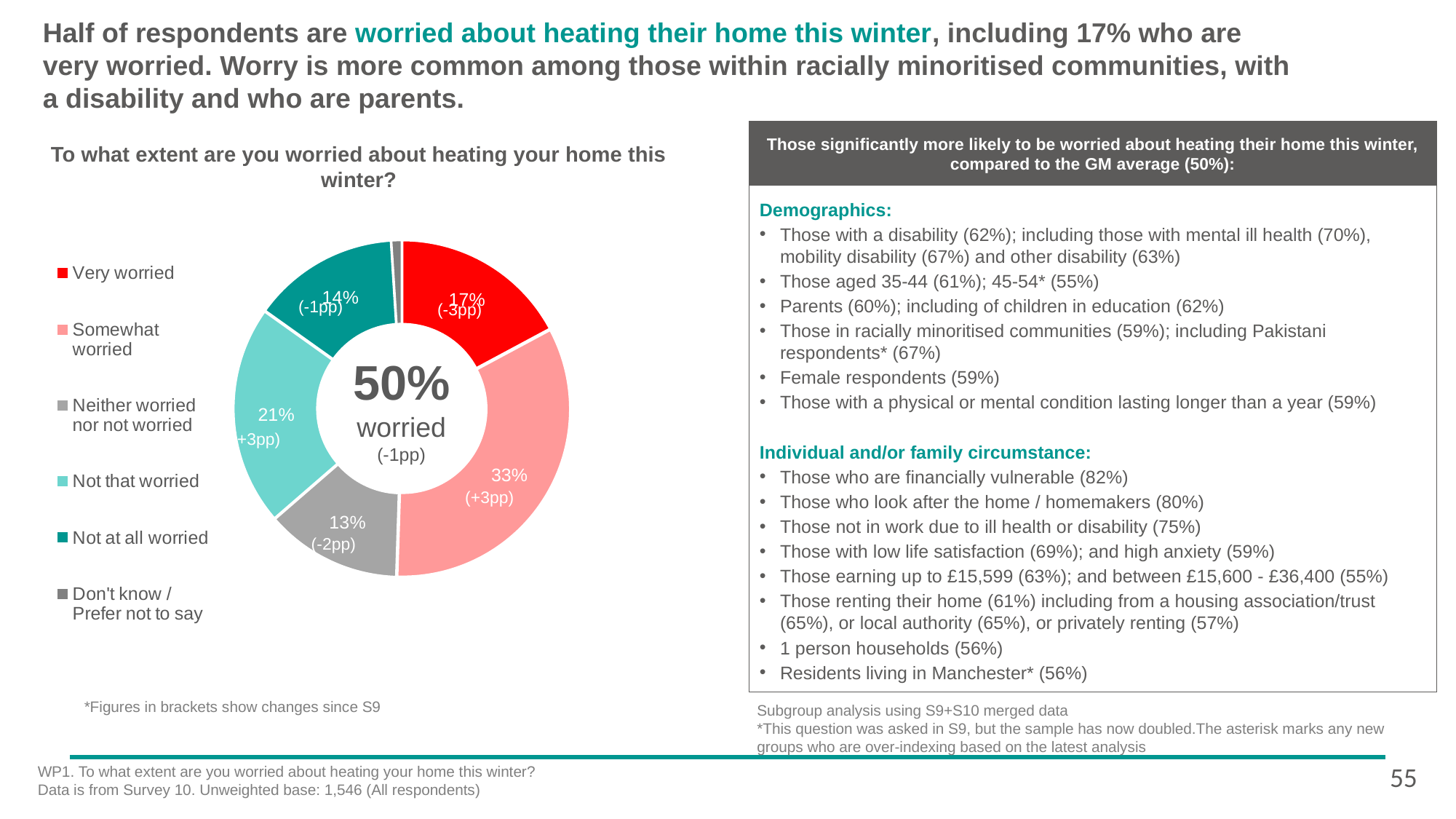
What is the change since S9 shown for the overall 'worried' figure in the centre of the chart? -1pp What percentage of respondents are very worried about heating their home this winter? 17% How many response categories does the chart legend list? 6 What percentage of respondents are neither worried nor not worried? 13% What is the difference in percentage points between 'Somewhat worried' and 'Very worried'? 16 Which response category has the largest share of the donut chart? Somewhat worried What is the change since S9 shown for the 'Very worried' slice? -3pp What percentage of respondents are not that worried? 21% What type of chart is used to show the responses to the heating worry question? Donut (pie) chart What is the combined percentage of respondents who are very worried or somewhat worried, as shown in the centre of the chart? 50% Which is larger: the share for 'Not that worried' or the share for 'Not at all worried'? Not that worried What percentage of respondents are somewhat worried? 33%